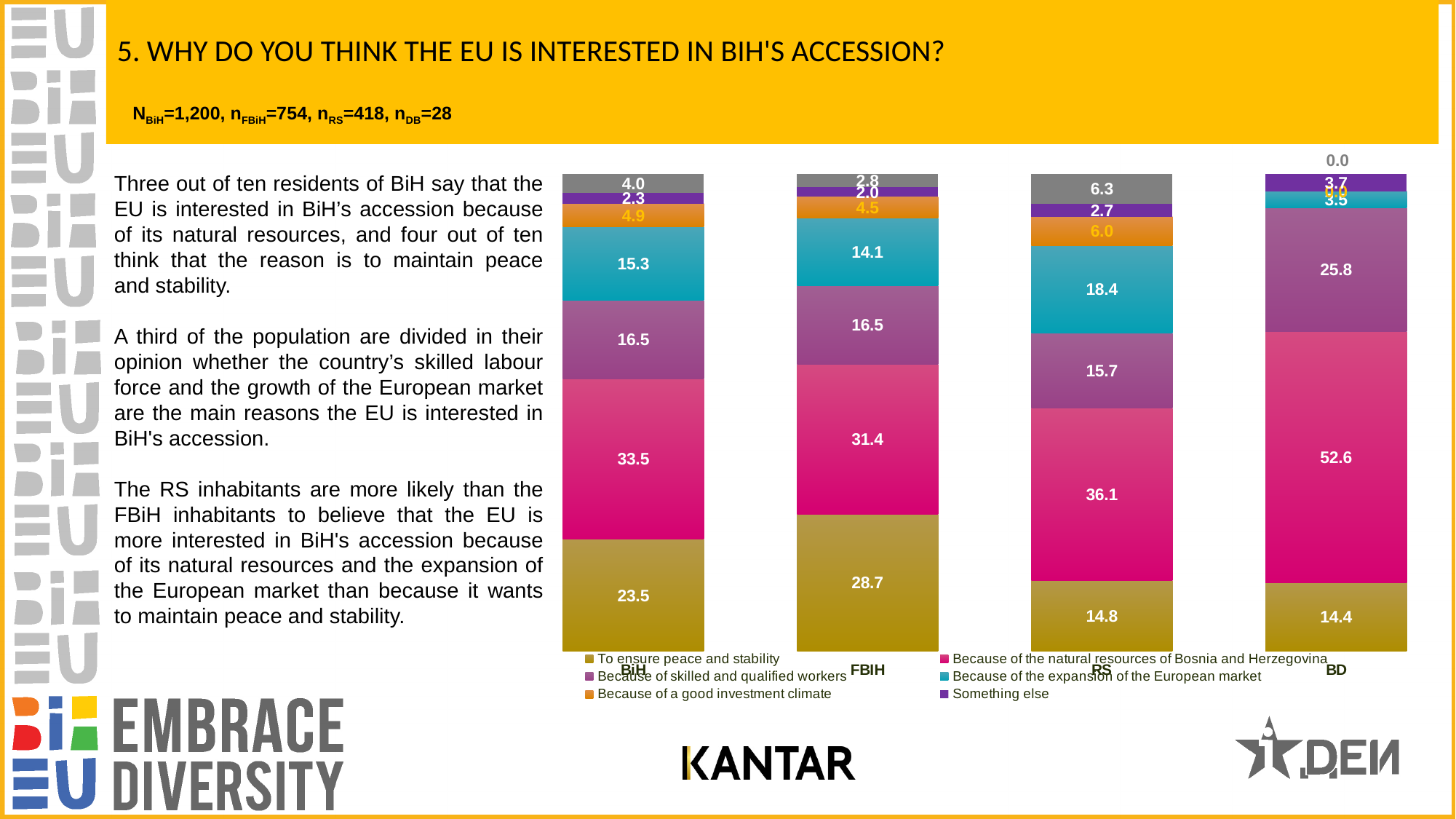
Which is larger for 'To ensure peace and stability': BiH or FBIH? FBIH What is the difference between the RS and BiH values for 'Because of the natural resources of Bosnia and Herzegovina'? 2.6 What is the value for 'Because of the natural resources of Bosnia and Herzegovina' in the BD bar? 52.6 What is the value for 'To ensure peace and stability' in the FBIH bar? 28.7 What is the value for 'Because of the expansion of the European market' in the RS bar? 18.4 How many regions (bars) are shown on the x axis of the chart? 4 What is the value for 'Because of the natural resources of Bosnia and Herzegovina' in the BiH bar? 33.5 What is the difference between the BD and BiH values for 'Because of skilled and qualified workers'? 9.3 How many series does the chart legend list? 6 Which region has the highest value for 'Because of the natural resources of Bosnia and Herzegovina'? BD What is the value for 'Because of a good investment climate' in the RS bar? 6.0 Which region has the lowest value for 'To ensure peace and stability'? BD